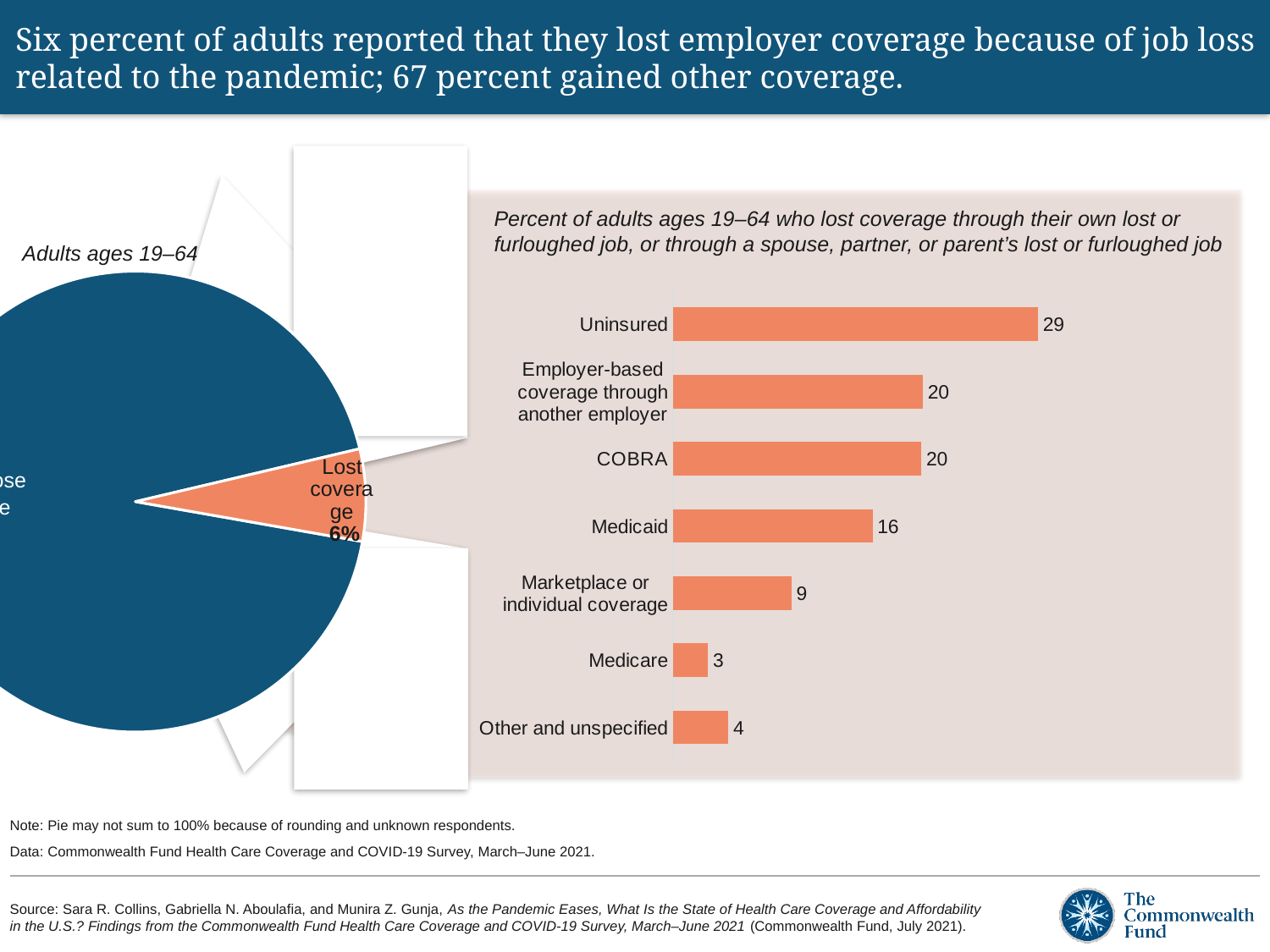
How many categories are shown in the bar chart on the right? 7 What kind of chart is the chart on the left side of the slide? Pie chart In the bar chart on the right, which category has the highest value? Uninsured In the pie chart on the left, what share is labelled for the Lost coverage slice? 6% In the bar chart on the right, what is the value for Medicaid? 16 In the bar chart on the right, what is the value for Marketplace or individual coverage? 9 In the bar chart on the right, which is larger: the value for Medicare or the value for Other and unspecified? Other and unspecified In the bar chart on the right, what is the value for Uninsured? 29 What kind of chart is the chart on the right side of the slide? Bar chart In the bar chart on the right, what is the value for COBRA? 20 In the bar chart on the right, which category has the lowest value? Medicare In the bar chart on the right, what is the difference between the values for Uninsured and Medicaid? 13